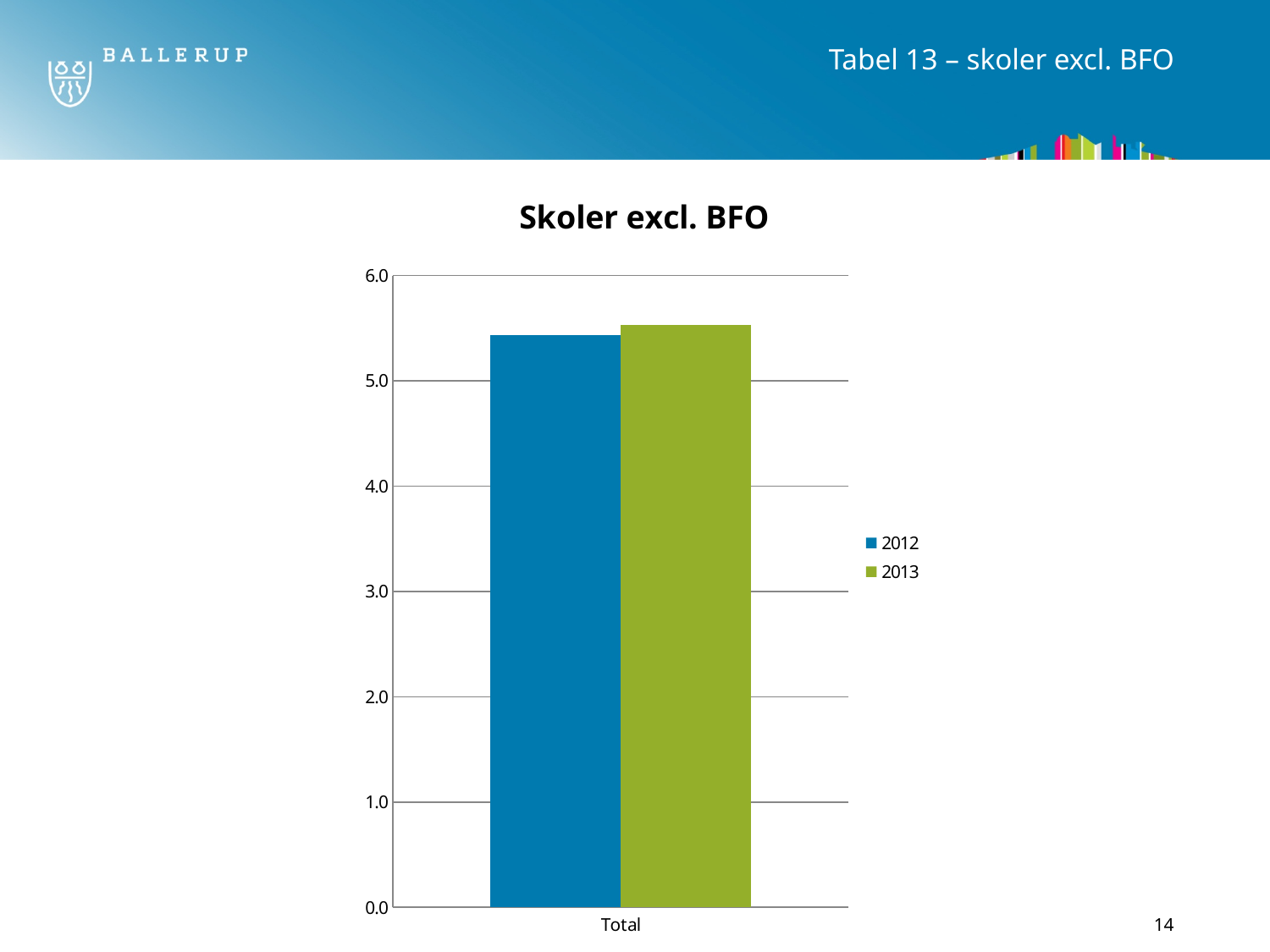
Is the value for 2013 in the Total category greater or less than 5.0? greater What is the title of the chart? Skoler excl. BFO Which series has the taller bar in the Total category, 2012 or 2013? 2013 How many series does the legend list? 2 What is the label of the category on the x axis? Total How many categories are shown on the x axis? 1 What kind of chart is shown on the slide? bar chart What is the highest value shown on the y axis? 6.0 Is the value for 2012 in the Total category greater or less than 5.0? greater Which series are listed in the legend? 2012 and 2013 Is the value for 2012 in the Total category greater or less than 4.0? greater